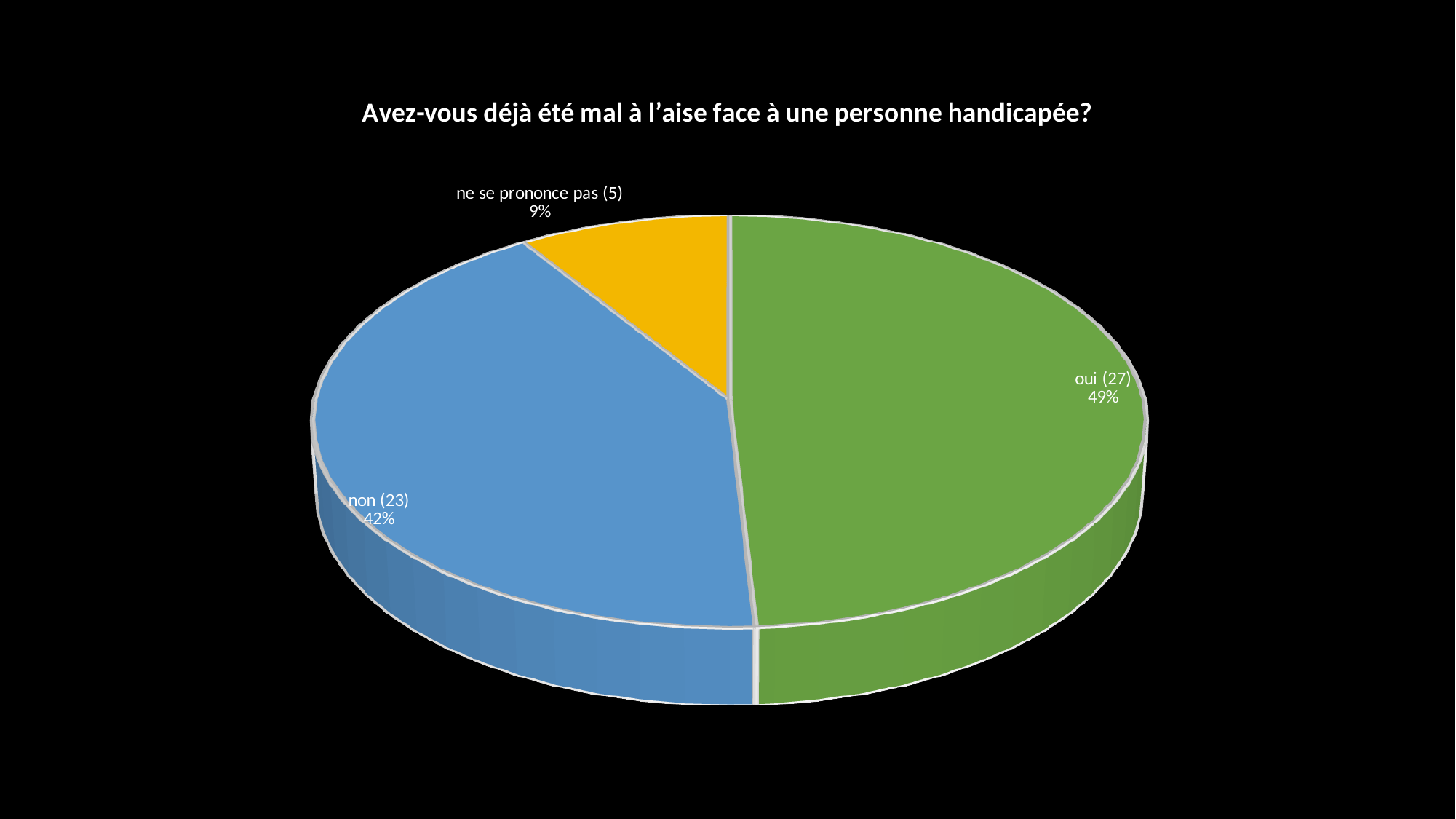
What percentage share does the "ne se prononce pas" slice represent? 9% What is the difference in respondent count between "oui" and "non"? 4 What kind of chart is shown on the slide? pie chart Which category has the largest slice? oui How many respondents are in the "ne se prononce pas" category? 5 What percentage share does the "oui" slice represent? 49% What is the title of the chart? Avez-vous déjà été mal à l'aise face à une personne handicapée? What percentage share does the "non" slice represent? 42% Which category has the smallest slice? ne se prononce pas How many respondents answered "non"? 23 How many respondents answered "oui"? 27 How many slices does the pie chart have? 3